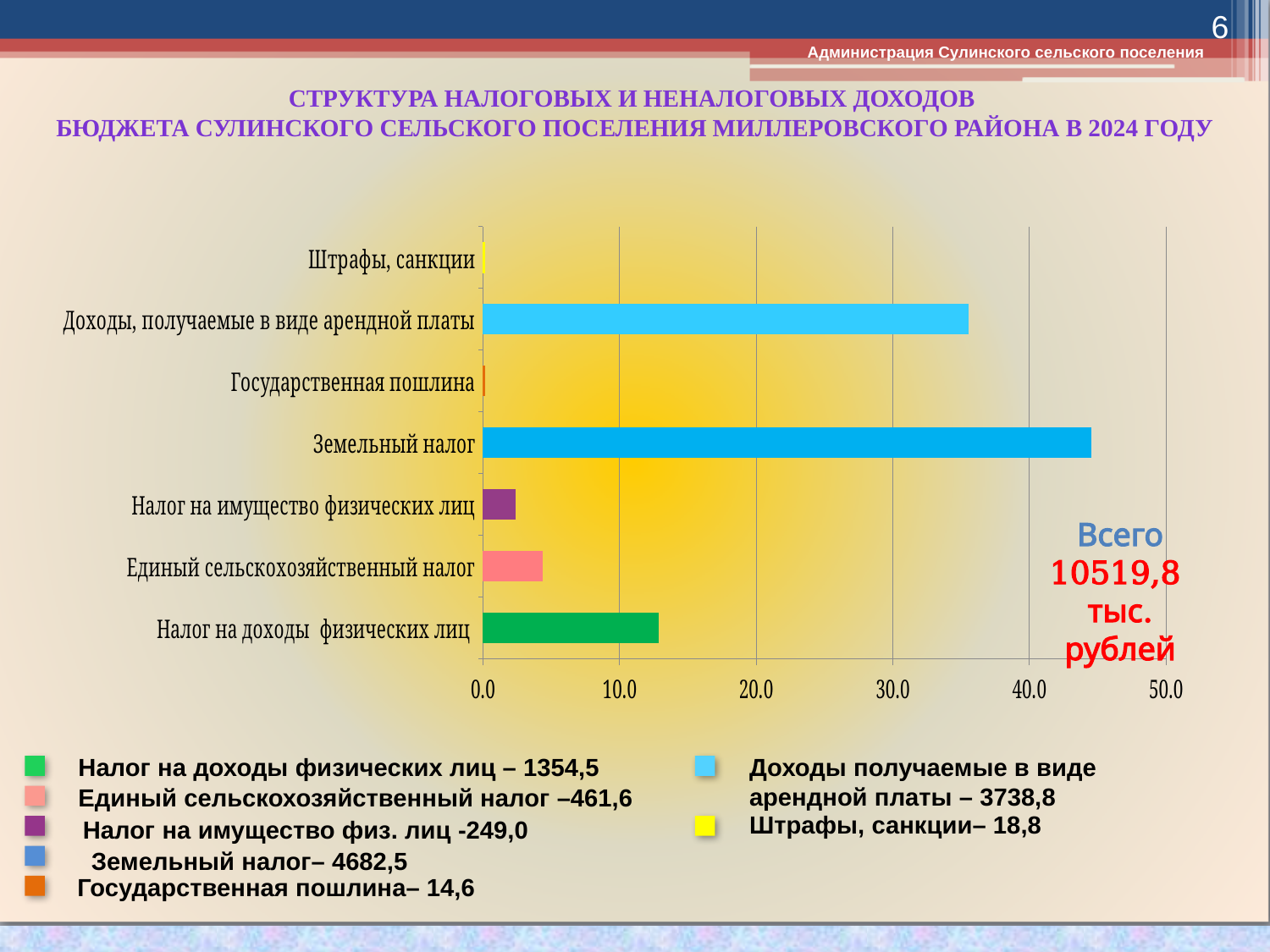
Is the bar for Налог на доходы физических лиц greater or less than 20.0? less According to the legend, what amount is given for Земельный налог? 4682,5 Is the bar for Единый сельскохозяйственный налог greater or less than 10.0? less Is the bar for Земельный налог greater or less than 40.0? greater Which category has the longest bar on the chart? Земельный налог What kind of chart is shown on the slide? bar chart Which is larger: Земельный налог or Доходы, получаемые в виде арендной платы? Земельный налог Which category has the smallest value according to the legend? Государственная пошлина According to the legend, what amount is given for Штрафы, санкции? 18,8 How many categories are plotted on the chart? 7 What total amount (Всего) is shown on the slide? 10519,8 тыс. рублей